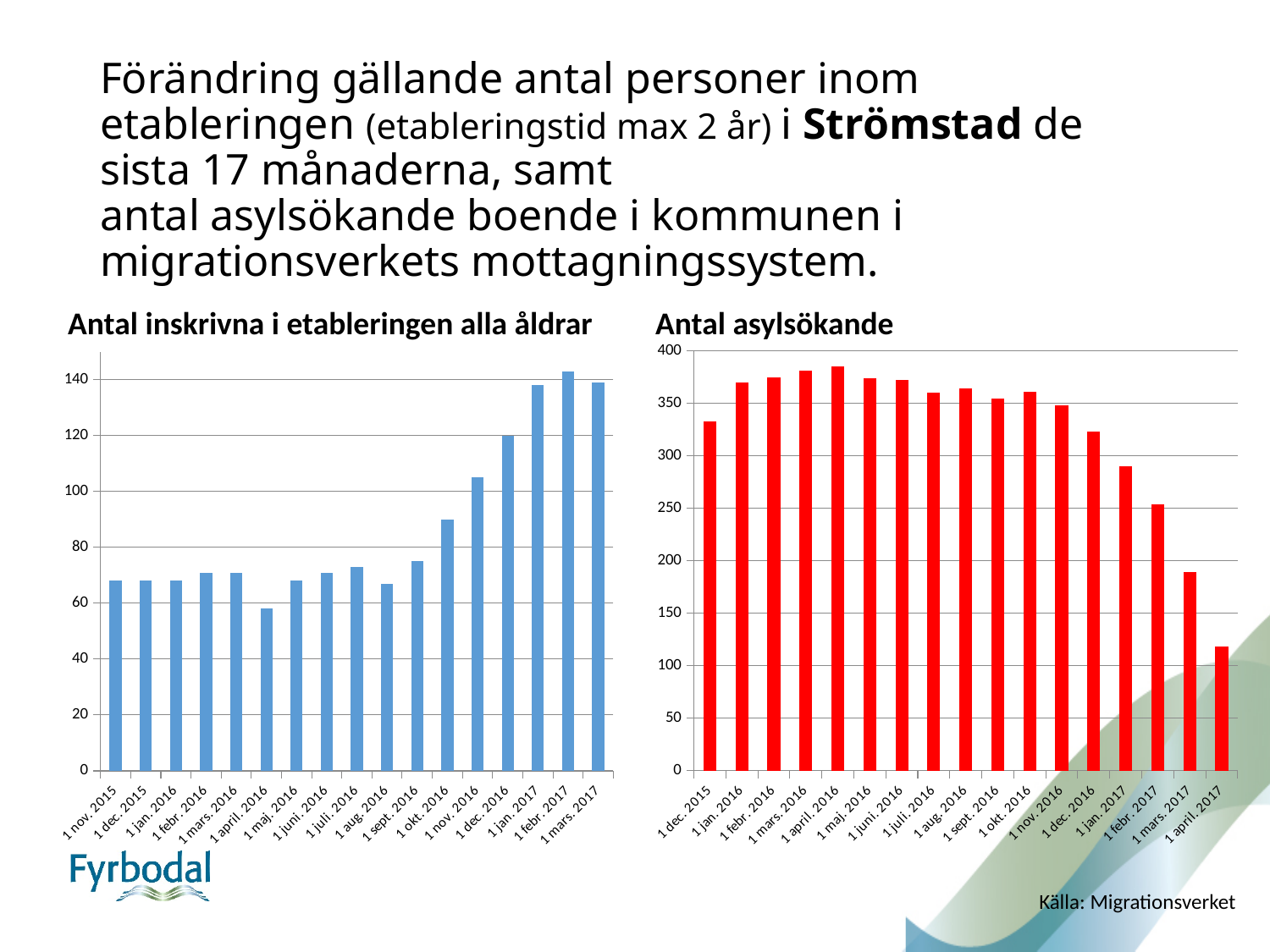
In the 'Antal asylsökande' chart, do the values rise or fall from 1 nov. 2016 to 1 april 2017? fall In the 'Antal asylsökande' chart, which is larger, the value for 1 mars 2017 or the value for 1 febr. 2017? 1 febr. 2017 In the 'Antal asylsökande' chart, is the value for 1 april 2017 greater or less than 150? less How many bars are shown in the 'Antal inskrivna i etableringen alla åldrar' chart? 17 In the 'Antal inskrivna i etableringen alla åldrar' chart, is the value for 1 april 2016 greater or less than 60? less How many bars are shown in the 'Antal asylsökande' chart? 17 In the 'Antal asylsökande' chart, which month has the lowest value? 1 april 2017 What kind of chart is the 'Antal asylsökande' chart? bar chart In the 'Antal asylsökande' chart, is the value for 1 dec. 2015 greater or less than 300? greater In the 'Antal inskrivna i etableringen alla åldrar' chart, which month has the highest value? 1 febr. 2017 In the 'Antal inskrivna i etableringen alla åldrar' chart, which month has the lowest value? 1 april 2016